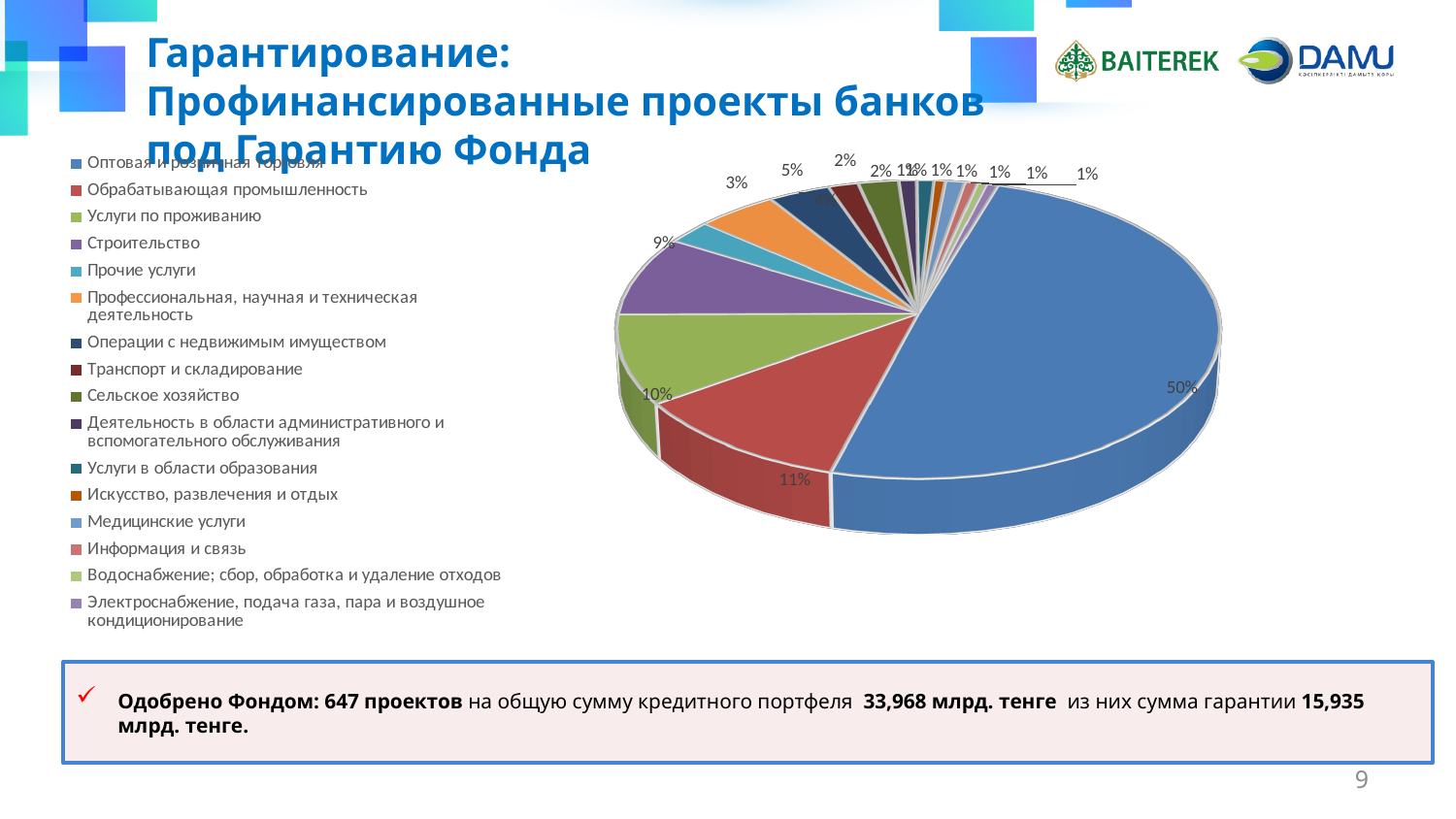
Which is larger, the share for Строительство or the share for Услуги по проживанию? Услуги по проживанию What is the value shown for Прочие услуги? 3% What kind of chart is shown on the slide? Pie chart Which category has the largest share of the pie? Оптовая и розничная торговля What is the value shown for Строительство? 9% What is the value shown for Услуги по проживанию? 10% What is the difference in percentage points between Оптовая и розничная торговля and Обрабатывающая промышленность? 39 percentage points What colour is the largest slice of the pie? Blue What share of the pie does Оптовая и розничная торговля have? 50% What is the value shown for Обрабатывающая промышленность? 11% How many categories does the legend list? 16 What is the value shown for Профессиональная, научная и техническая деятельность? 5%